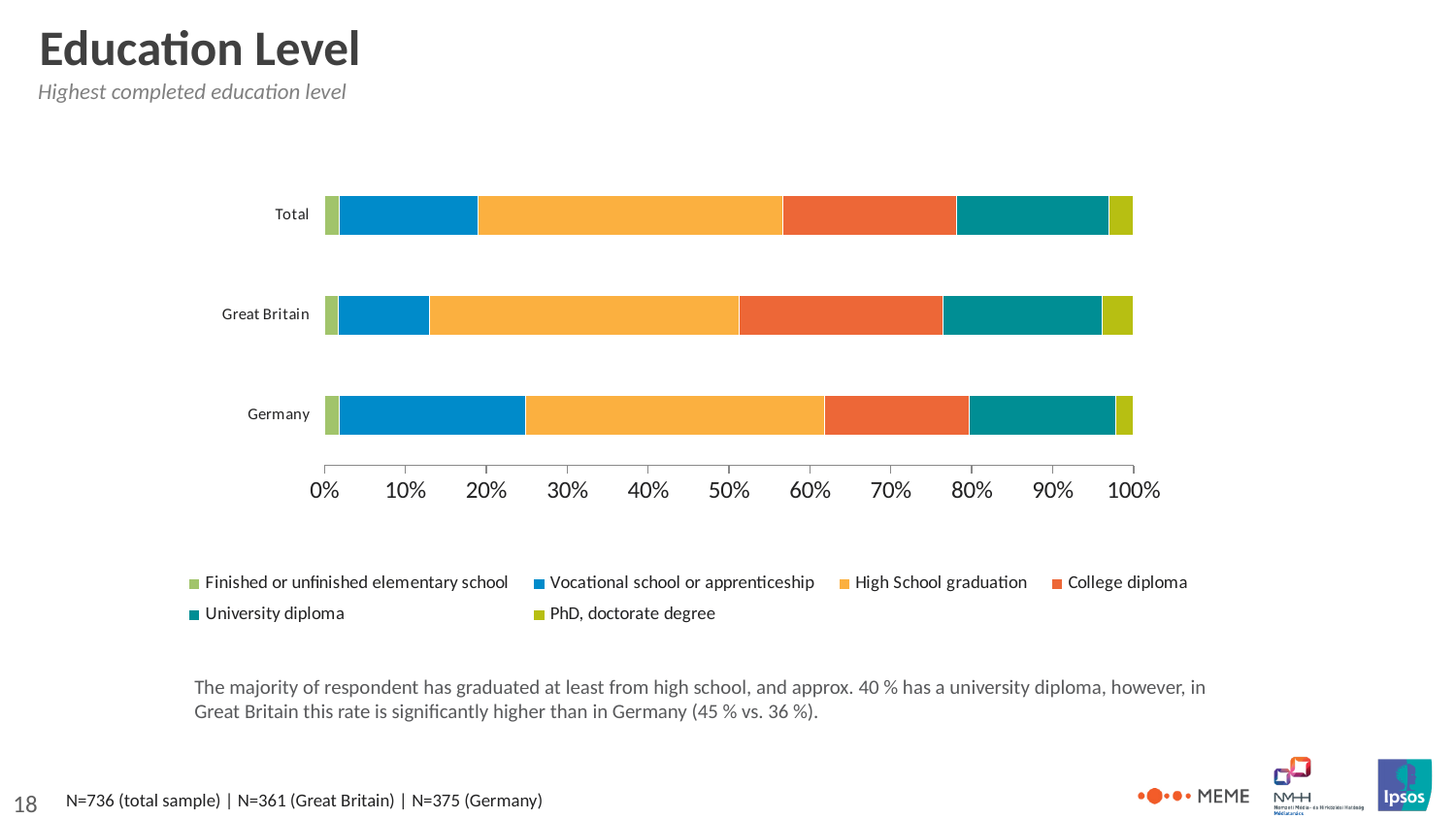
What is the title of the chart on the slide? Education Level Is the share of Vocational school or apprenticeship for Great Britain greater or less than 20%? less What kind of chart is shown on the slide? Stacked bar chart Which legend entry is shown in orange-red (the fourth series)? College diploma Which education level takes up the largest share of the Germany bar? High School graduation How many series does the legend list? 6 Is the share of Vocational school or apprenticeship for Germany greater or less than 20%? greater How many categories (bars) are shown on the chart? 3 Which has a larger share of College diploma, Great Britain or Germany? Great Britain Which has a larger share of Vocational school or apprenticeship, Germany or Great Britain? Germany Which education level takes up the largest share of the Total bar? High School graduation Is the share of High School graduation for Total greater or less than 30%? greater